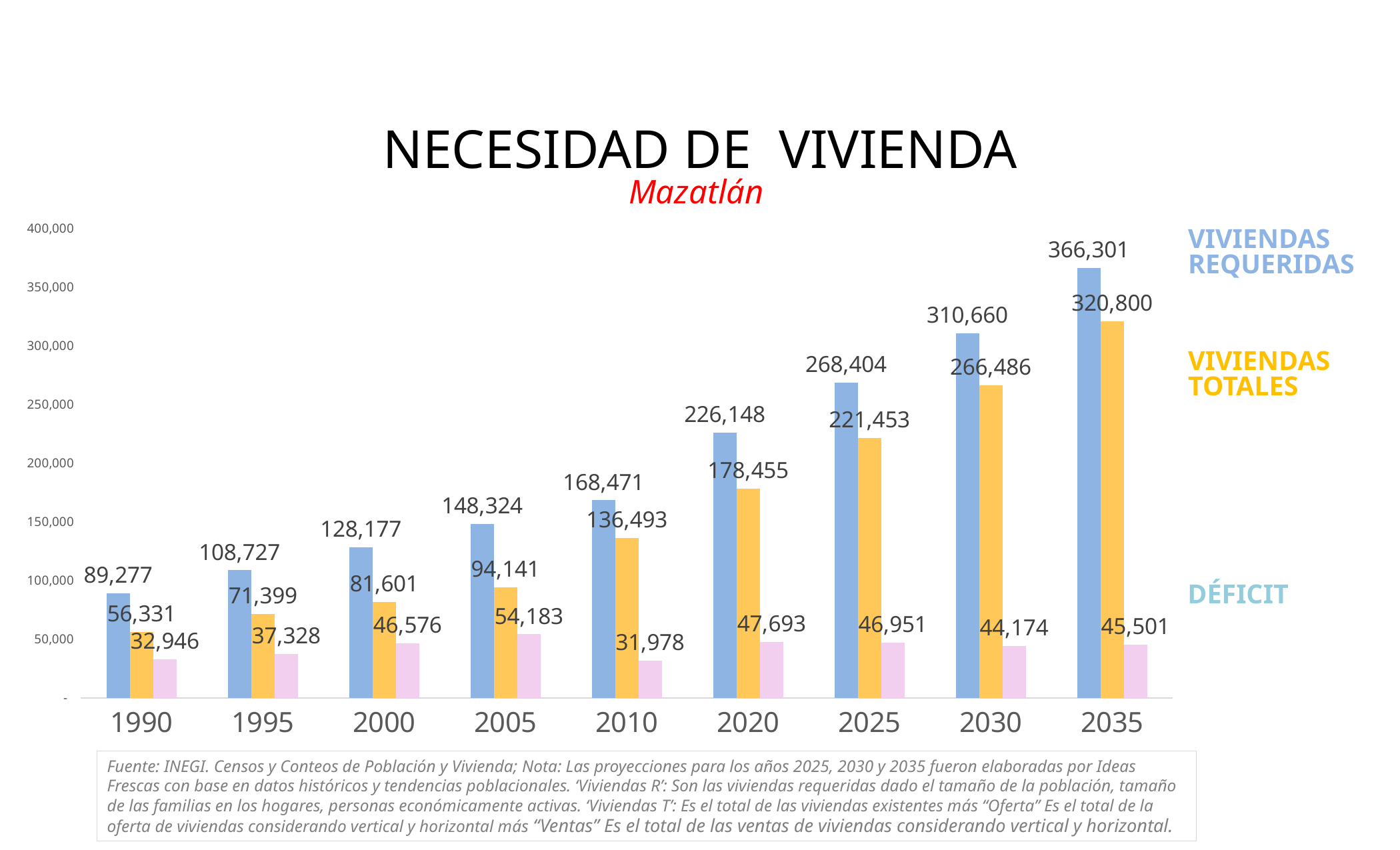
Which is larger, the Déficit in 2020 or the Déficit in 2025? 2020 By how much did Viviendas Requeridas increase from 2025 to 2030? 42,256 What is the value of Viviendas Totales for 2010? 136,493 How many years are shown on the x axis? 9 Is the value of Viviendas Totales for 2030 greater or less than 250,000? greater In which year is the Déficit highest? 2005 In which year is the Déficit lowest? 2010 What is the value of Viviendas Requeridas for 2035? 366,301 What is the difference between Viviendas Requeridas and Viviendas Totales in 2035? 45,501 What kind of chart is shown on the slide? Bar chart What is the Déficit value for 1990? 32,946 How many series does the chart show? 3